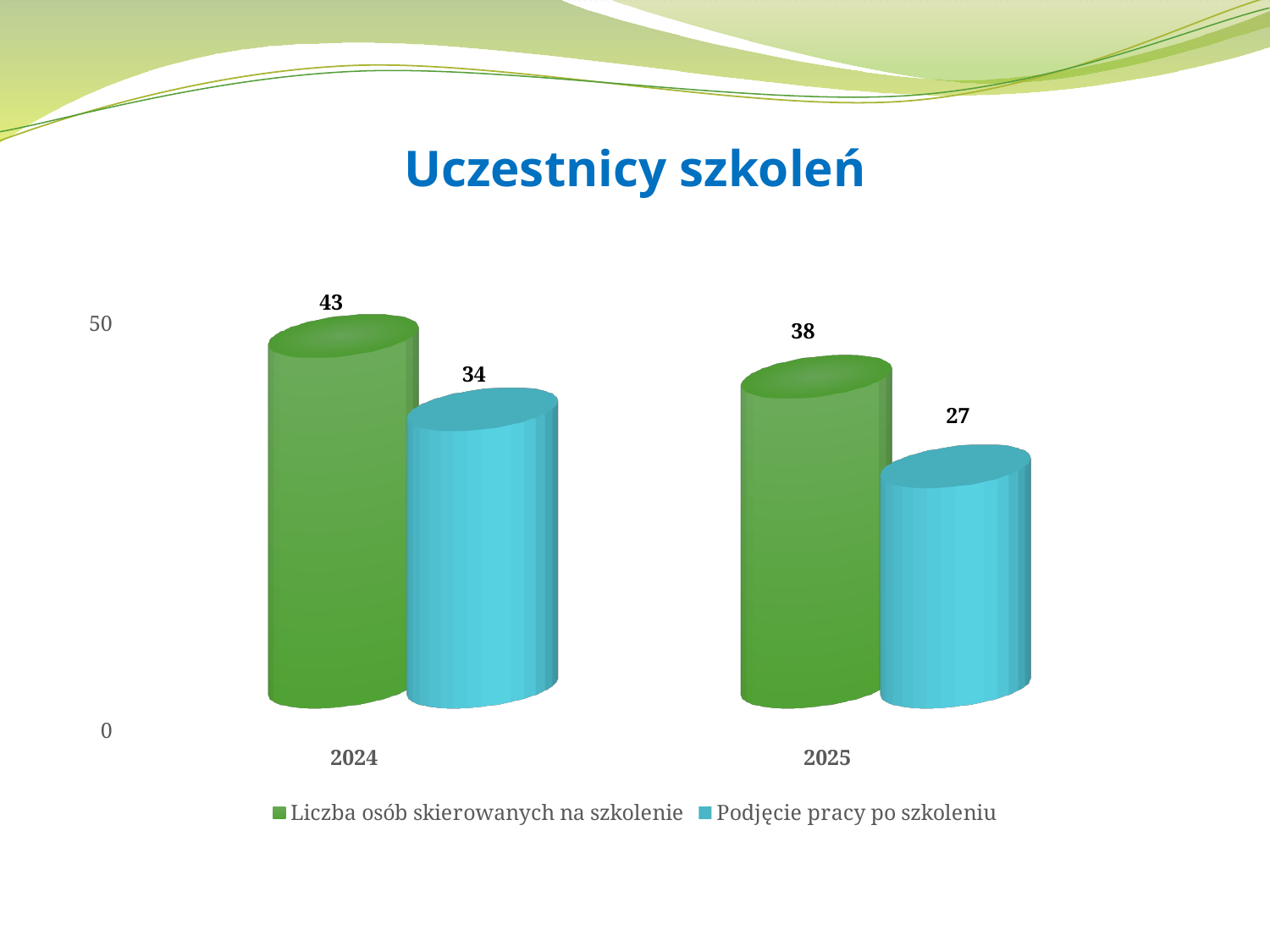
Which year has the lowest value for 'Podjęcie pracy po szkoleniu'? 2025 What is the difference between 'Liczba osób skierowanych na szkolenie' in 2024 and in 2025? 5 How many series does the legend list? 2 What is the value for 'Podjęcie pracy po szkoleniu' in 2024? 34 What is the value for 'Podjęcie pracy po szkoleniu' in 2025? 27 What kind of chart is shown on the slide? bar chart Which is larger: 'Podjęcie pracy po szkoleniu' in 2024 or in 2025? 2024 What is the value for 'Liczba osób skierowanych na szkolenie' in 2024? 43 What is the difference between 'Liczba osób skierowanych na szkolenie' and 'Podjęcie pracy po szkoleniu' in 2024? 9 What is the value for 'Liczba osób skierowanych na szkolenie' in 2025? 38 What is the title of the chart? Uczestnicy szkoleń Which year has the highest value for 'Liczba osób skierowanych na szkolenie'? 2024